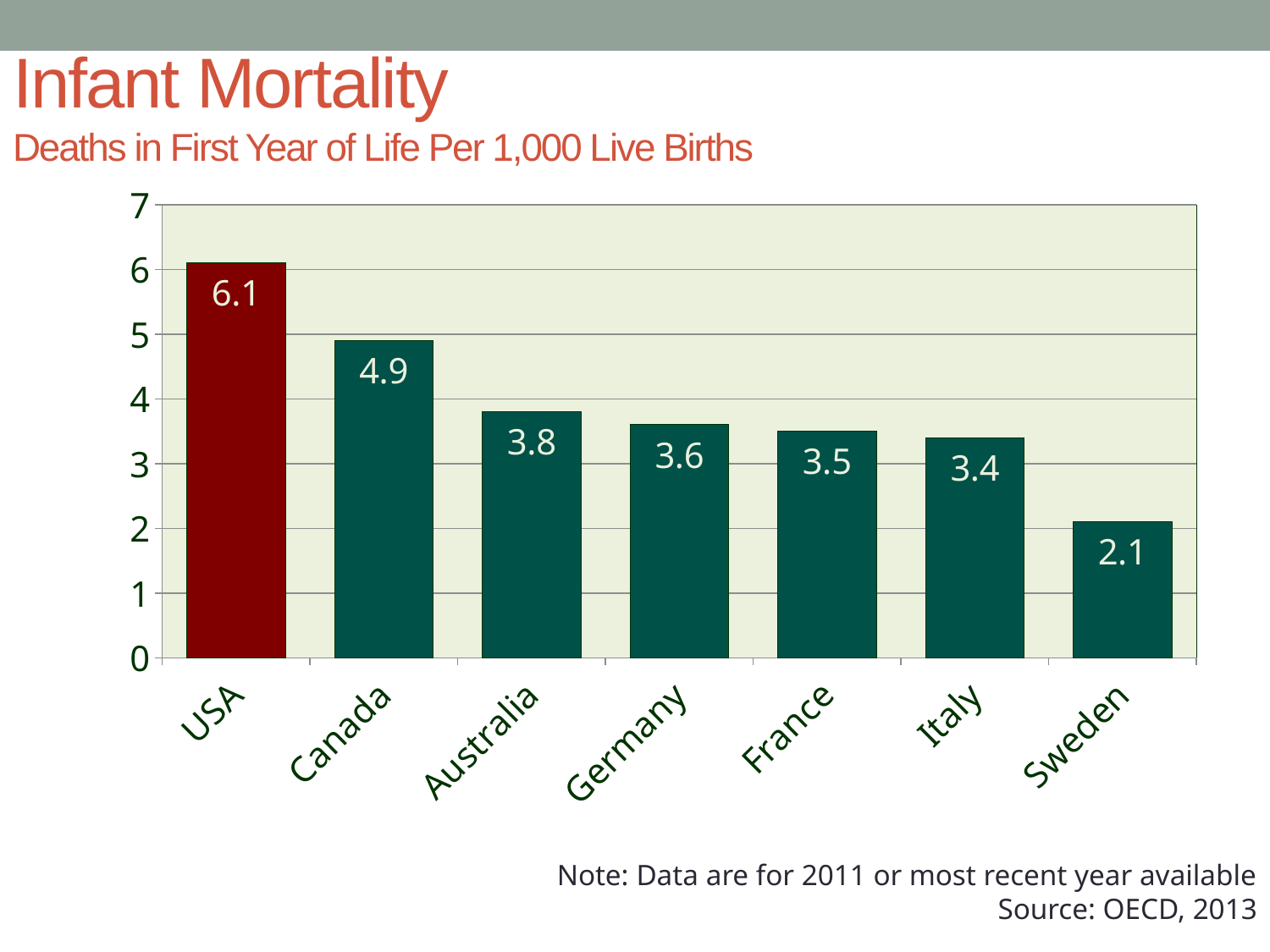
How many countries are shown on the chart? 7 Which has a higher value, Germany or Italy? Germany What kind of chart is shown on the slide? bar chart What is the value shown for Canada? 4.9 Is the value for France greater or less than 4? less What is the difference between the values for Canada and Australia? 1.1 What is the value shown for Sweden? 2.1 Which bar is coloured differently (dark red) from the others? USA What is the infant mortality rate shown for the USA? 6.1 Which country has the lowest infant mortality rate on the chart? Sweden Which country has the highest infant mortality rate on the chart? USA What is the difference between the values for the USA and Sweden? 4.0